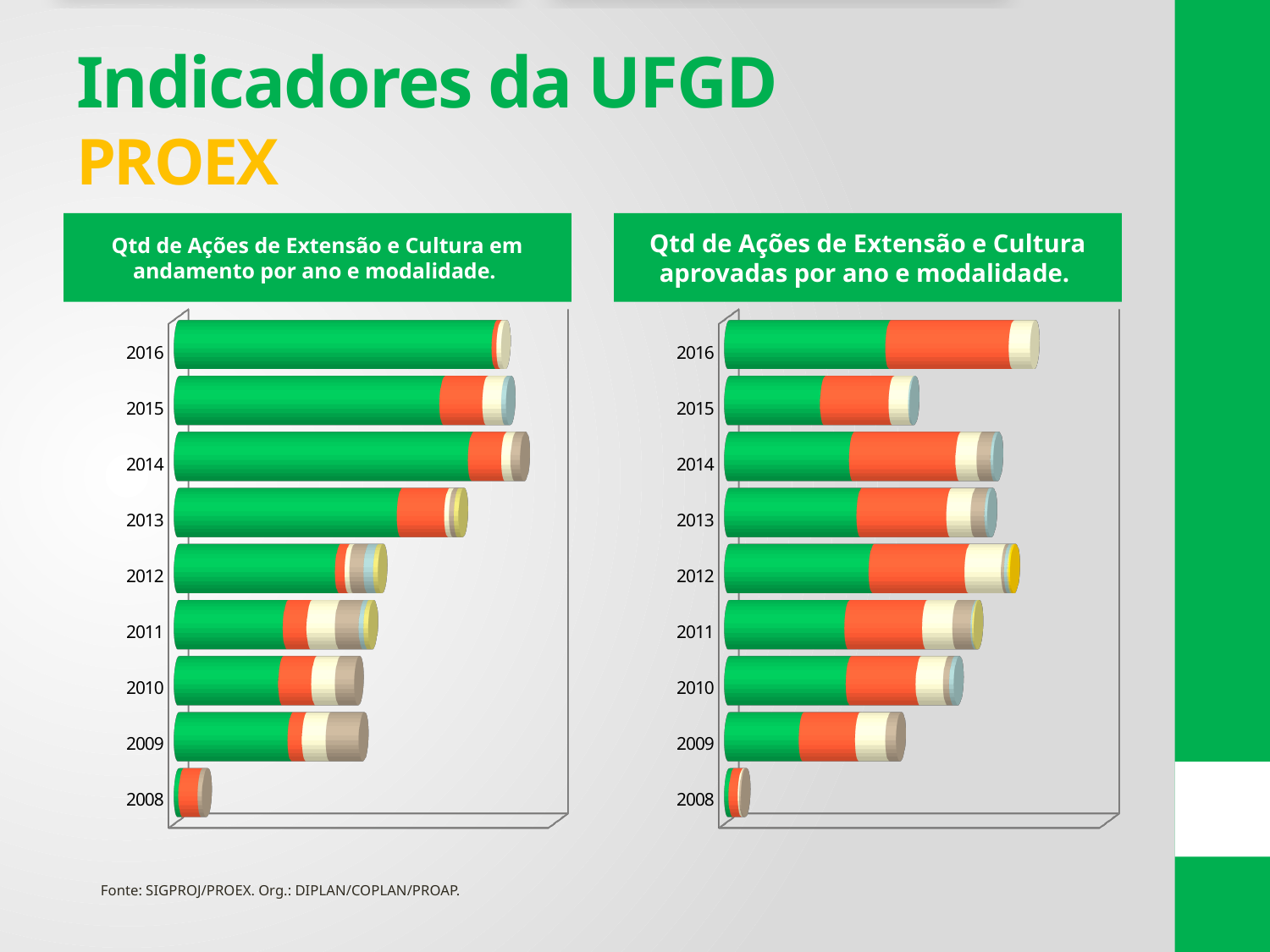
In the right chart (ações aprovadas), which year has the longer total bar, 2009 or 2010? 2010 What kind of chart is the left chart, 'Qtd de Ações de Extensão e Cultura em andamento por ano e modalidade'? Stacked bar chart In the right chart (ações aprovadas), how many years are shown? 9 In the right chart (ações aprovadas), which year has the longer total bar, 2014 or 2015? 2014 In the left chart (ações em andamento), how many years are shown? 9 What is the title of the right chart? Qtd de Ações de Extensão e Cultura aprovadas por ano e modalidade. In the left chart (ações em andamento), which year has the longest total bar? 2014 What kind of chart is the right chart, 'Qtd de Ações de Extensão e Cultura aprovadas por ano e modalidade'? Stacked bar chart In the right chart (ações aprovadas), which year has the shortest total bar? 2008 In the left chart (ações em andamento), which year has the longer total bar, 2012 or 2013? 2013 In the left chart (ações em andamento), do the total bars generally get longer or shorter from 2008 to 2014? Longer In the left chart (ações em andamento), which year has the shortest total bar? 2008